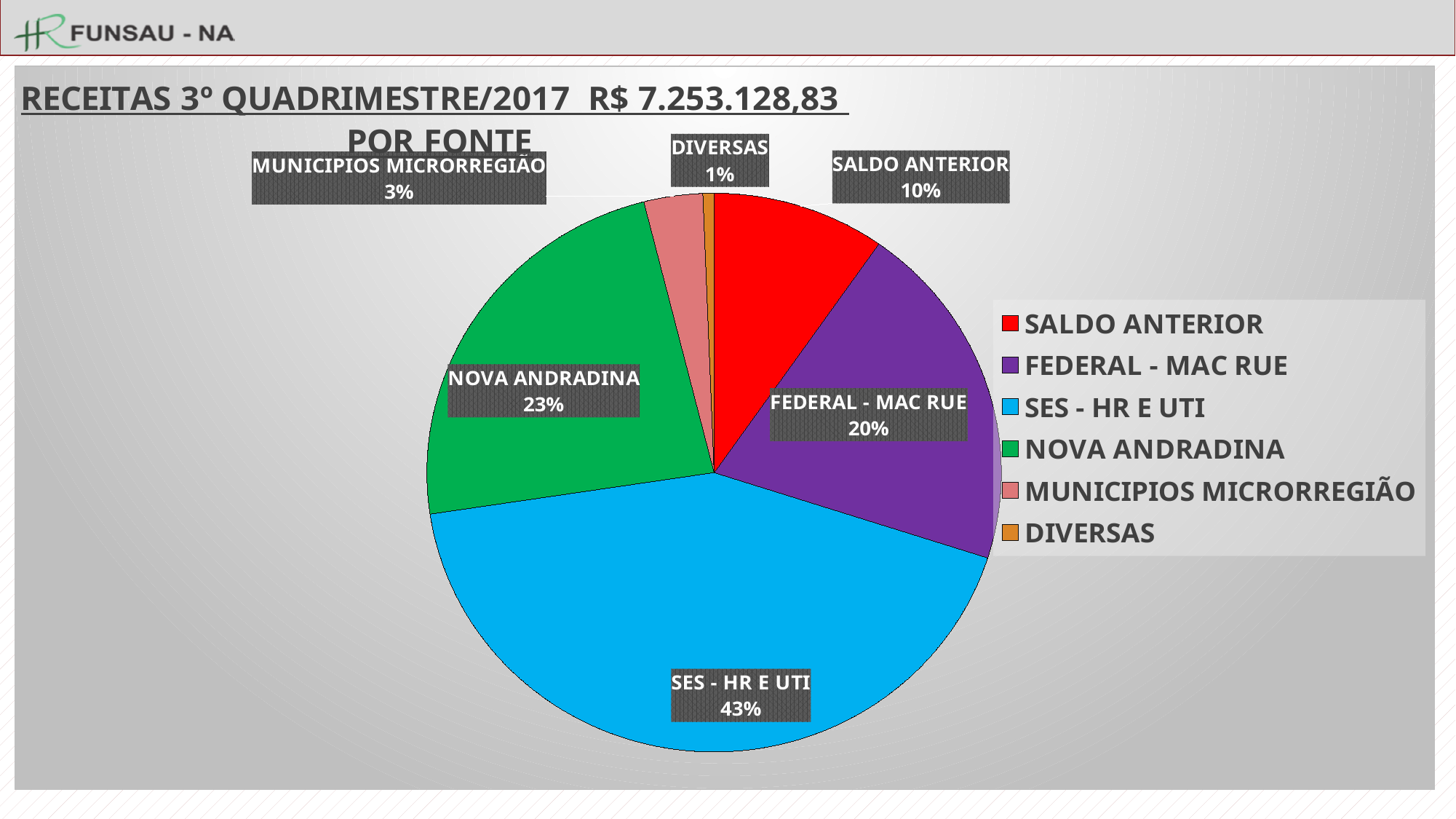
What share of the pie does SES - HR E UTI represent? 43% What percentage is shown for NOVA ANDRADINA? 23% What is the difference in percentage points between SES - HR E UTI and NOVA ANDRADINA? 20 Which is larger, the slice for FEDERAL - MAC RUE or the slice for SALDO ANTERIOR? FEDERAL - MAC RUE What kind of chart is shown on the slide? pie chart Which category has the largest slice of the pie? SES - HR E UTI How many categories does the legend list? 6 Which category has the smallest slice of the pie? DIVERSAS What percentage is shown for MUNICIPIOS MICRORREGIÃO? 3% What percentage is shown for SALDO ANTERIOR? 10% What colour is the slice for NOVA ANDRADINA? green What percentage is shown for FEDERAL - MAC RUE? 20%